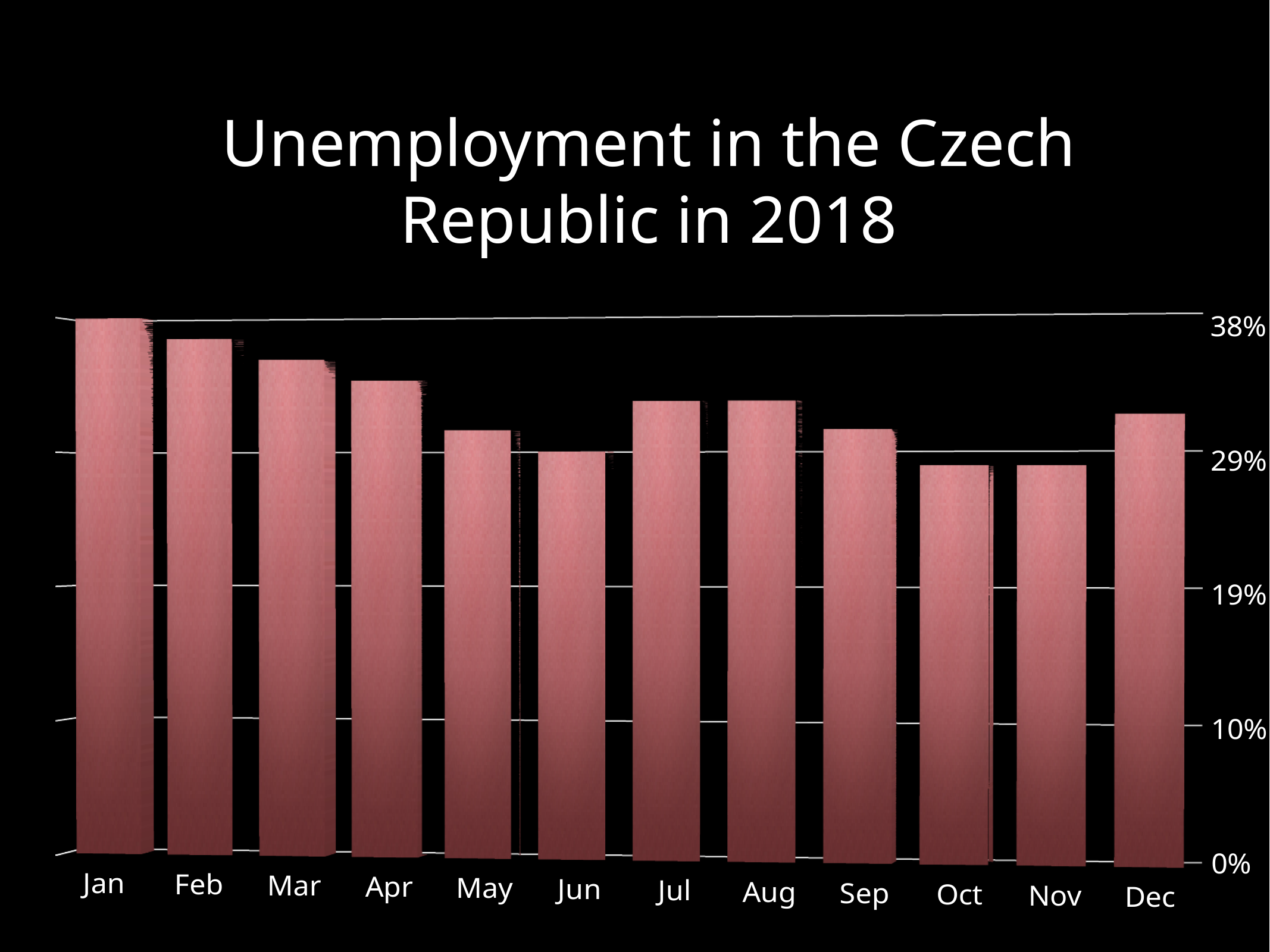
Is the value for Feb greater or less than 38%? less Is the value for Dec greater or less than 29%? greater How many months are plotted on the chart? 12 Which is larger, the value for Jan or the value for Jun? Jan Which is larger, the value for Jul or the value for Oct? Jul Which is larger, the value for Mar or the value for Sep? Mar What is the title of the chart? Unemployment in the Czech Republic in 2018 Is the value for Jan greater or less than 29%? greater Which month has the highest unemployment value? Jan What kind of chart is shown on the slide? Bar chart Do the values rise or fall from Jan to Jun? fall